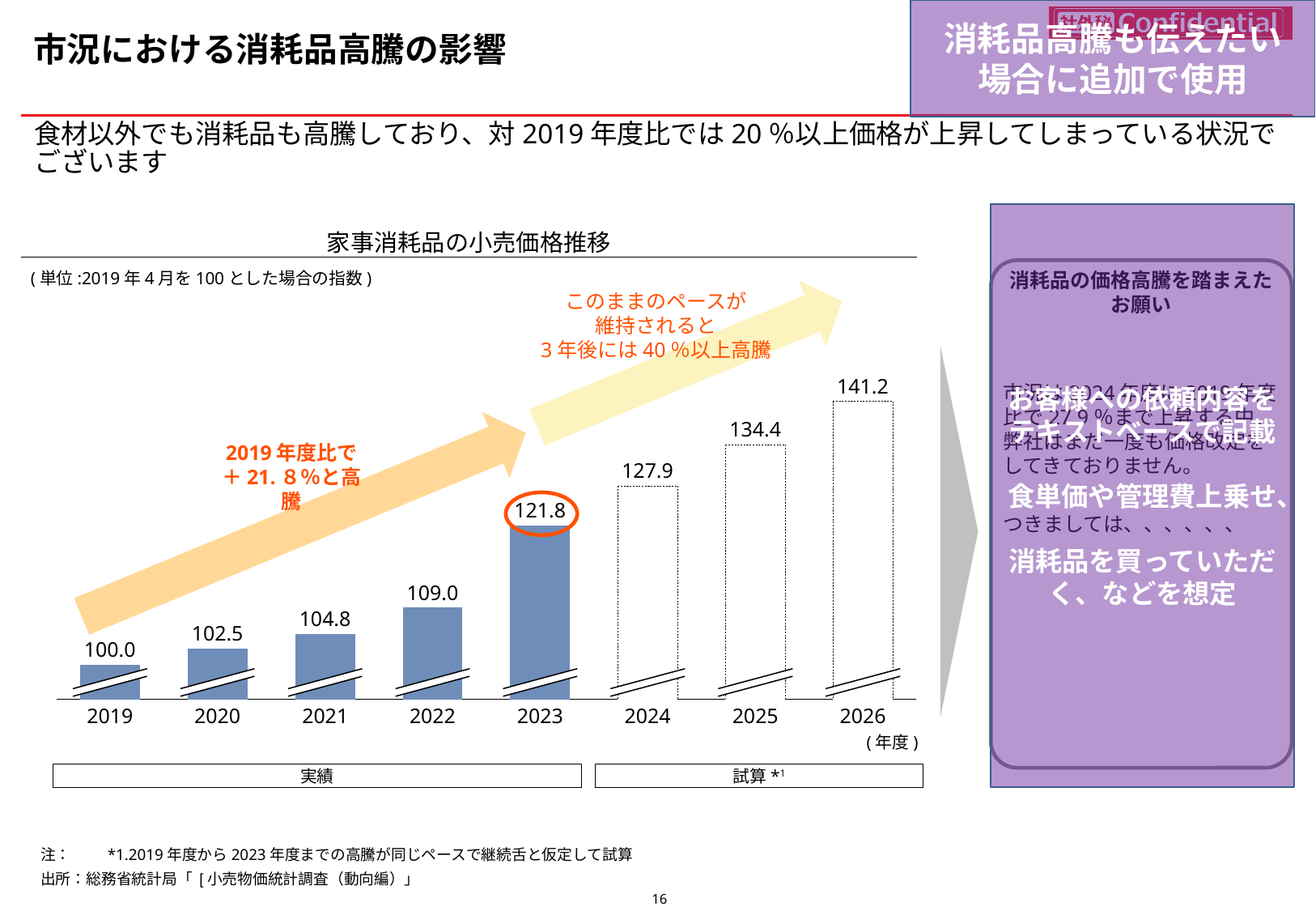
How many years are shown on the x axis of the 家事消耗品の小売価格推移 chart? 8 What kind of chart is the 家事消耗品の小売価格推移 chart? bar chart Which year has the highest value in the 家事消耗品の小売価格推移 chart? 2026 Which year has the lowest value in the 家事消耗品の小売価格推移 chart? 2019 What is the value for 2019 in the 家事消耗品の小売価格推移 chart? 100.0 What is the difference between the 2025 value and the 2024 value in the 家事消耗品の小売価格推移 chart? 6.5 What is the estimated value for 2026 in the 家事消耗品の小売価格推移 chart? 141.2 What is the value for 2021 in the 家事消耗品の小売価格推移 chart? 104.8 What is the value for 2023 in the 家事消耗品の小売価格推移 chart? 121.8 Do the values in the 家事消耗品の小売価格推移 chart rise or fall from 2019 to 2026? rise What is the difference between the 2023 value and the 2019 value in the 家事消耗品の小売価格推移 chart? 21.8 Which is larger in the 家事消耗品の小売価格推移 chart, the value for 2022 or the value for 2020? 2022